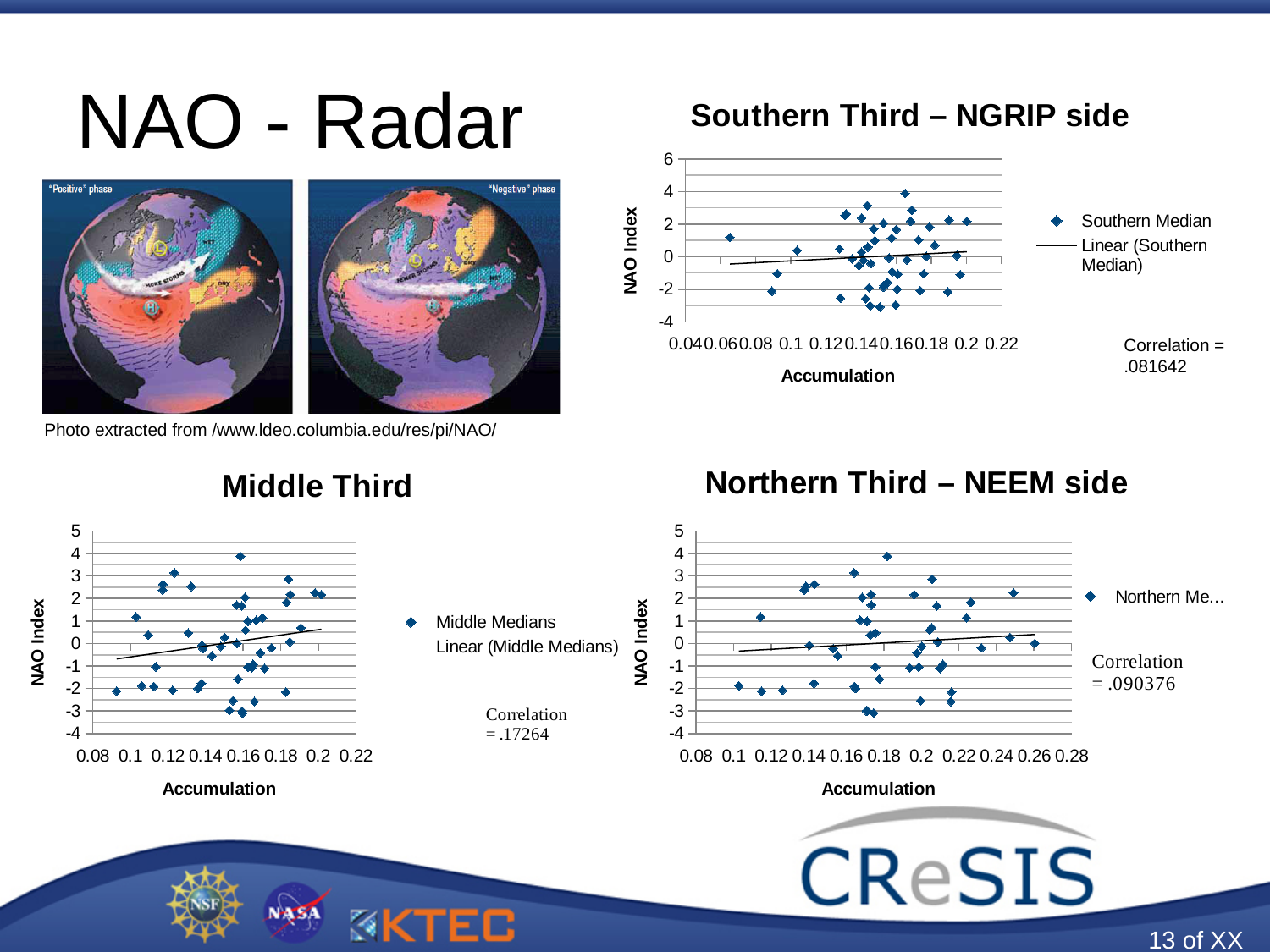
In the 'Northern Third – NEEM side' chart, is the highest NAO Index value plotted greater or less than 3? greater In the 'Southern Third – NGRIP side' chart, is the highest NAO Index value plotted greater or less than 3? greater What is the name of the point series in the legend of the 'Middle Third' chart? Middle Medians In the 'Middle Third' chart, is the lowest NAO Index value plotted greater or less than -2? less In the 'Middle Third' chart, does the linear trend line rise or fall as Accumulation increases? rise What kind of chart is the 'Southern Third – NGRIP side' chart? scatter chart What is the label of the x axis on the 'Middle Third' chart? Accumulation In the 'Northern Third – NEEM side' chart, does the linear trend line rise or fall as Accumulation increases? rise How many series does the legend of the 'Southern Third – NGRIP side' chart list? 2 How many series does the legend of the 'Middle Third' chart list? 2